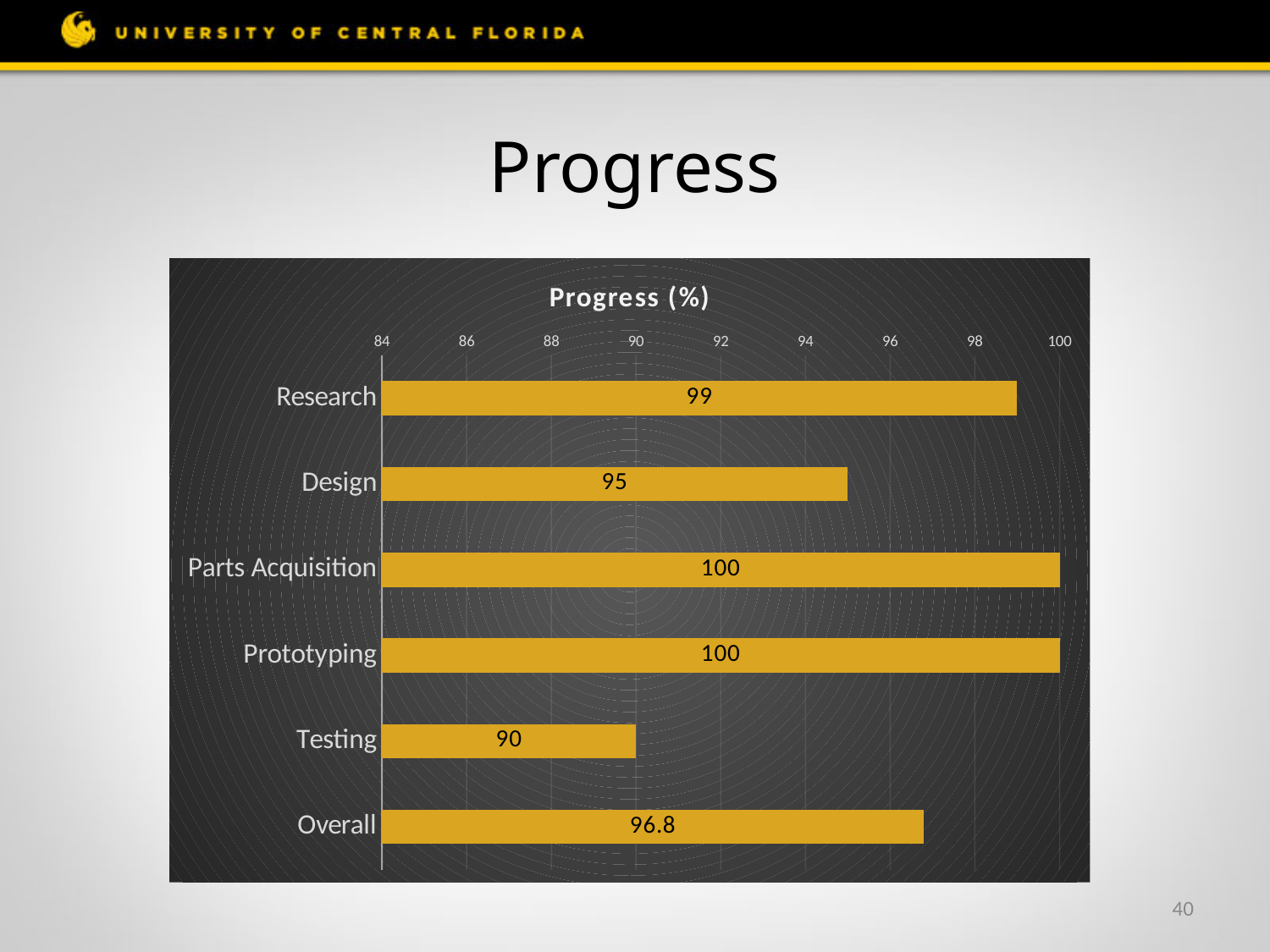
What is the title of the chart? Progress (%) What is the value for Testing? 90 Is the value for Design greater or less than 94? greater What is the difference between the values for Research and Design? 4 What is the value for Design? 95 Which is larger, the value for Design or the value for Overall? Overall What is the value for Research? 99 How many categories are shown in the chart? 6 What is the value for Overall? 96.8 What kind of chart is shown on the slide? bar chart Which category has the lowest value? Testing What is the difference between the values for Overall and Testing? 6.8